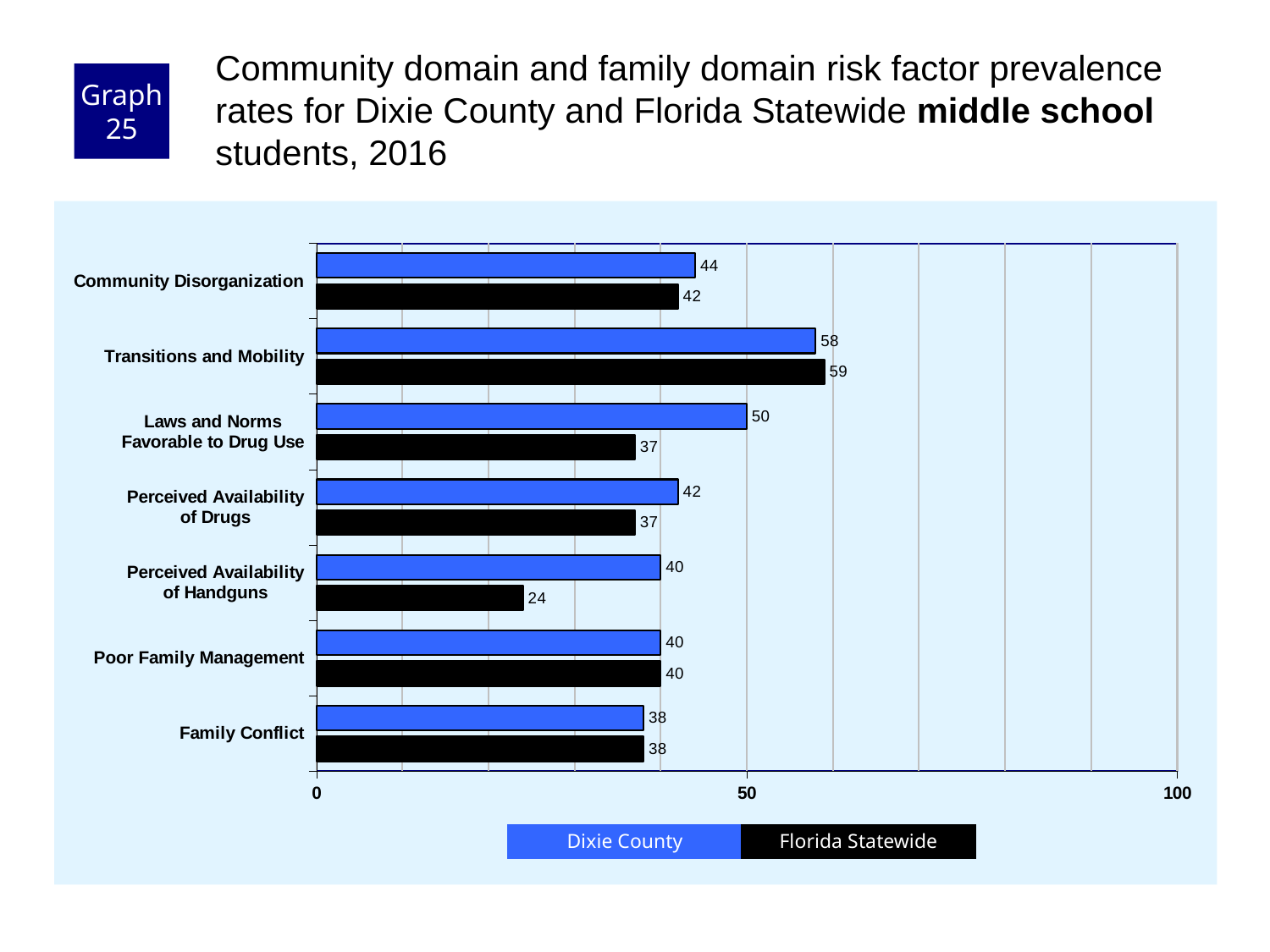
Which risk factor has the lowest Florida Statewide value? Perceived Availability of Handguns What is the Florida Statewide value for Transitions and Mobility? 59 What is the Florida Statewide value for Perceived Availability of Handguns? 24 What is the Dixie County value for Laws and Norms Favorable to Drug Use? 50 What kind of chart is shown on the slide? Bar chart How many risk factors are shown on the chart? 7 Which risk factor has the highest Dixie County value? Transitions and Mobility What is the difference between the Dixie County and Florida Statewide values for Perceived Availability of Handguns? 16 Is the Dixie County value for Transitions and Mobility greater or less than 50? greater For Perceived Availability of Drugs, which is larger: the Dixie County value or the Florida Statewide value? Dixie County How many series does the legend list? 2 What is the difference between the Dixie County and Florida Statewide values for Laws and Norms Favorable to Drug Use? 13